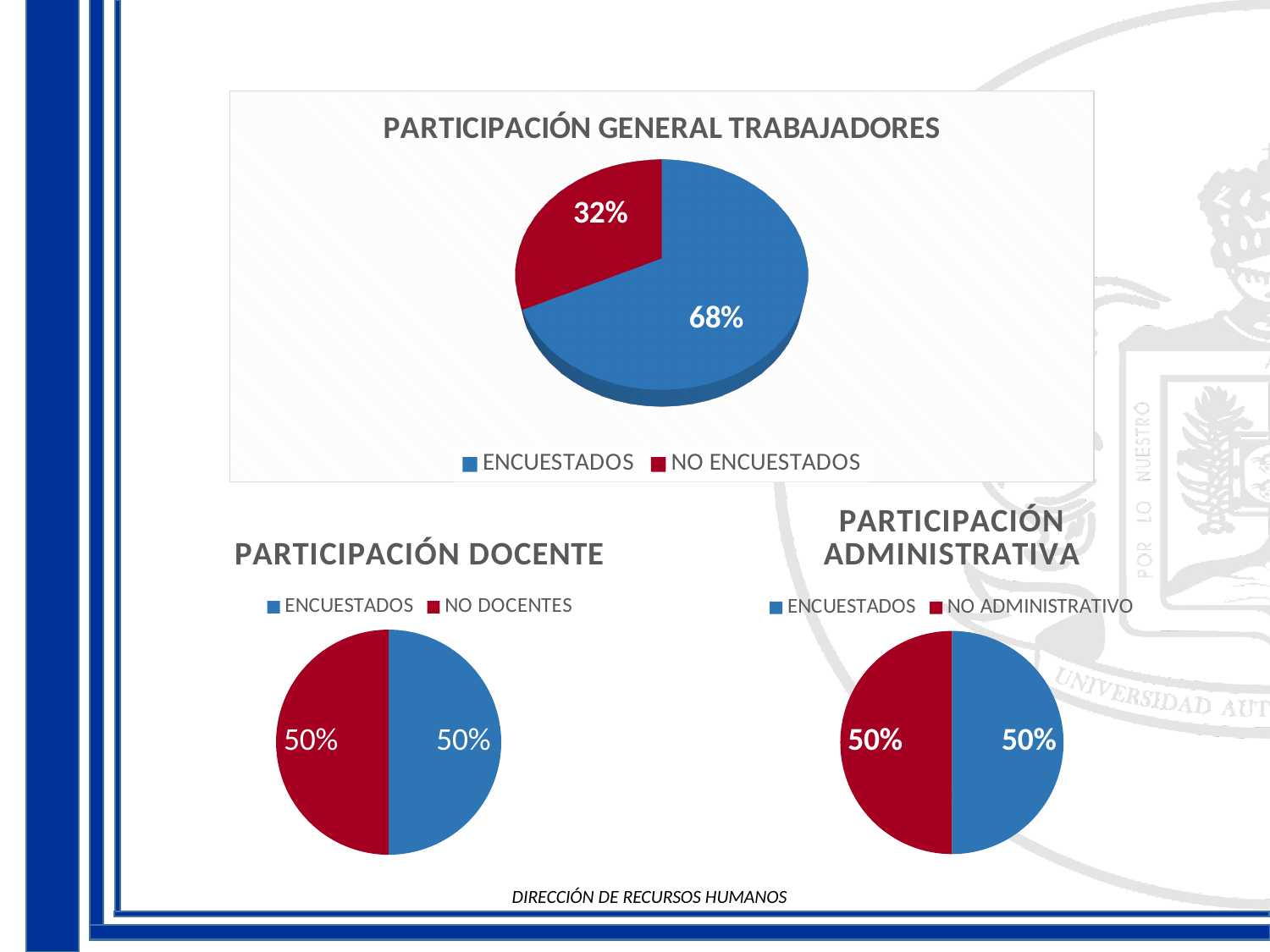
In the 'PARTICIPACIÓN DOCENTE' chart, what share of the pie is NO DOCENTES? 50% How many pie charts are shown on the slide? 3 In the 'PARTICIPACIÓN GENERAL TRABAJADORES' chart, which category has the largest slice? ENCUESTADOS In the 'PARTICIPACIÓN ADMINISTRATIVA' chart, what share of the pie is ENCUESTADOS? 50% What kind of chart is the 'PARTICIPACIÓN GENERAL TRABAJADORES' chart? Pie chart In the 'PARTICIPACIÓN GENERAL TRABAJADORES' chart, what share of the pie is ENCUESTADOS? 68% How many categories does the legend of the 'PARTICIPACIÓN DOCENTE' chart list? 2 In the 'PARTICIPACIÓN GENERAL TRABAJADORES' chart, which is larger, ENCUESTADOS or NO ENCUESTADOS? ENCUESTADOS In the 'PARTICIPACIÓN GENERAL TRABAJADORES' chart, what is the difference in percentage points between ENCUESTADOS and NO ENCUESTADOS? 36 In the 'PARTICIPACIÓN GENERAL TRABAJADORES' chart, which category has the smallest slice? NO ENCUESTADOS What are the two legend entries of the 'PARTICIPACIÓN ADMINISTRATIVA' chart? ENCUESTADOS and NO ADMINISTRATIVO